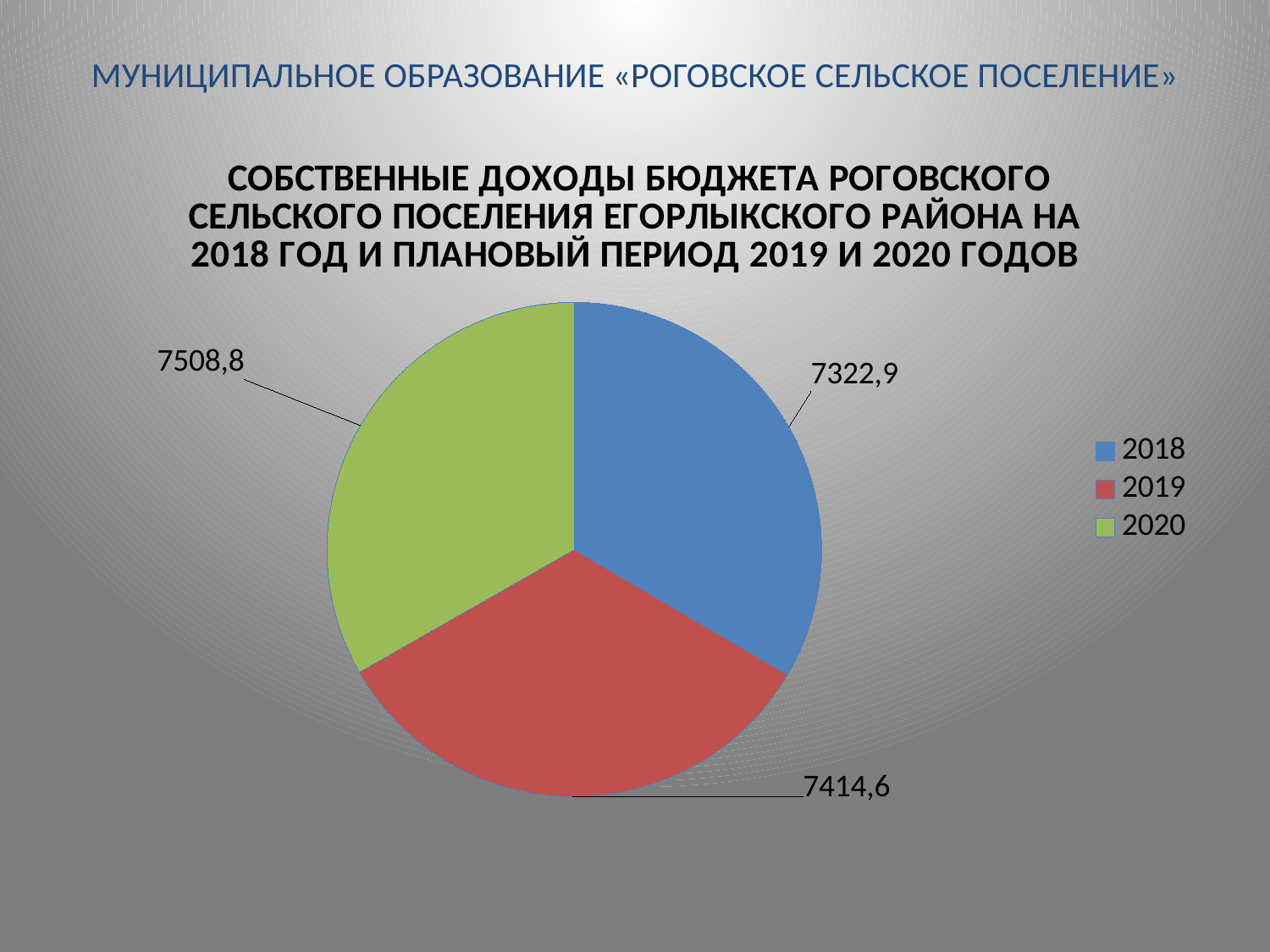
What colour is the slice for 2019? Red What is the value shown for 2020 on the pie chart? 7508,8 How many slices does the pie chart have? 3 What is the difference between the values for 2019 and 2018? 91,7 What is the value shown for 2019 on the pie chart? 7414,6 What kind of chart is shown on the slide? Pie chart How many entries does the legend list? 3 What is the difference between the values for 2020 and 2018? 185,9 Which is larger, the value for 2019 or the value for 2020? 2020 Which year has the smallest value on the pie chart? 2018 What is the value shown for 2018 on the pie chart? 7322,9 Which year has the largest value on the pie chart? 2020